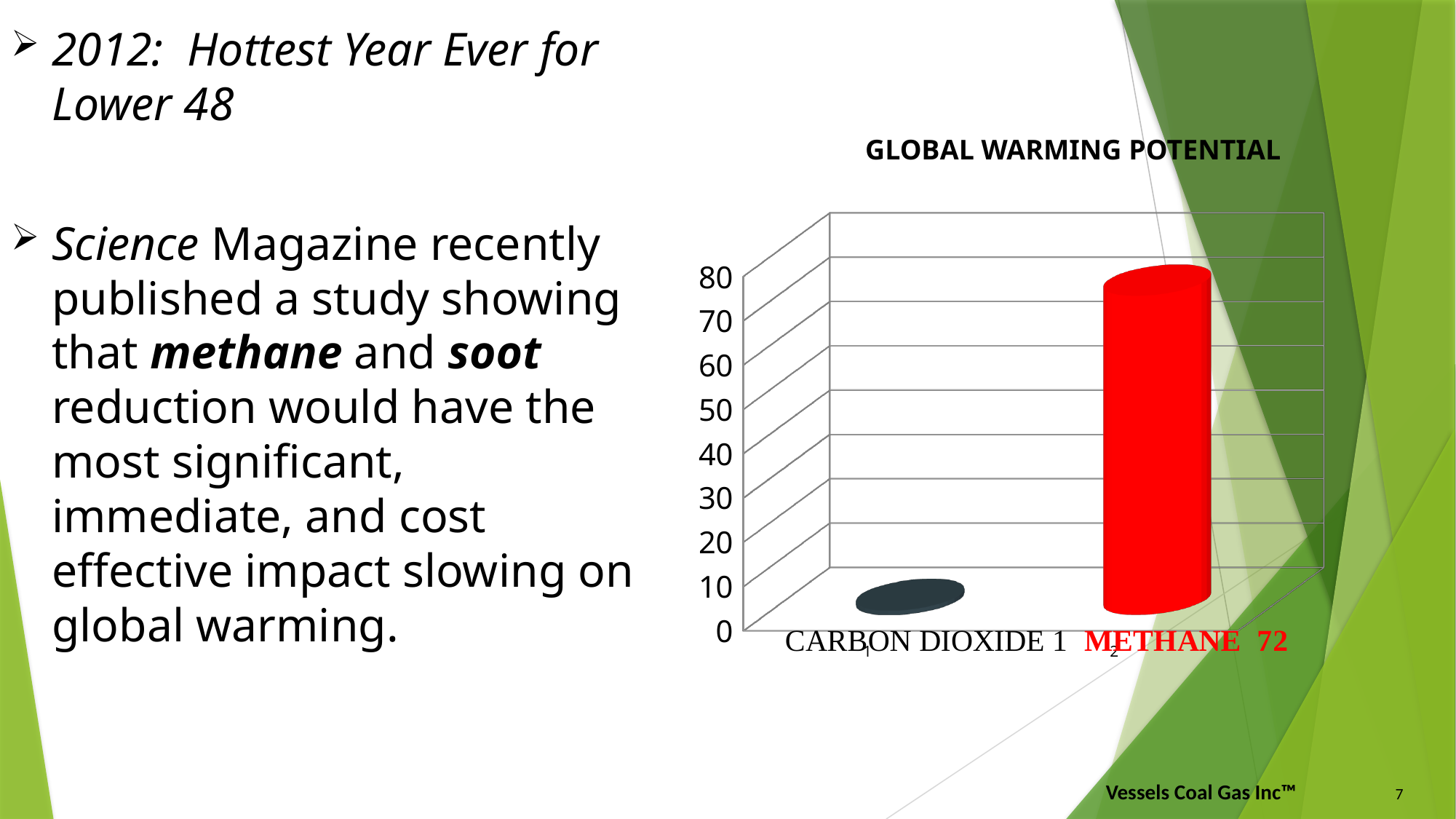
What global warming potential value is shown for carbon dioxide? 1 Which category has the highest value in the chart? METHANE How many categories are plotted in the chart? 2 Is the value for methane greater or less than 60? greater Which category has the lowest value in the chart? CARBON DIOXIDE What kind of chart is shown on the slide? bar chart What global warming potential value is shown for methane? 72 Is the value for carbon dioxide greater or less than 10? less What is the difference between the methane value and the carbon dioxide value? 71 What colour is the methane bar in the chart? red What is the title of the chart? GLOBAL WARMING POTENTIAL Which is larger, the value for methane or the value for carbon dioxide? METHANE